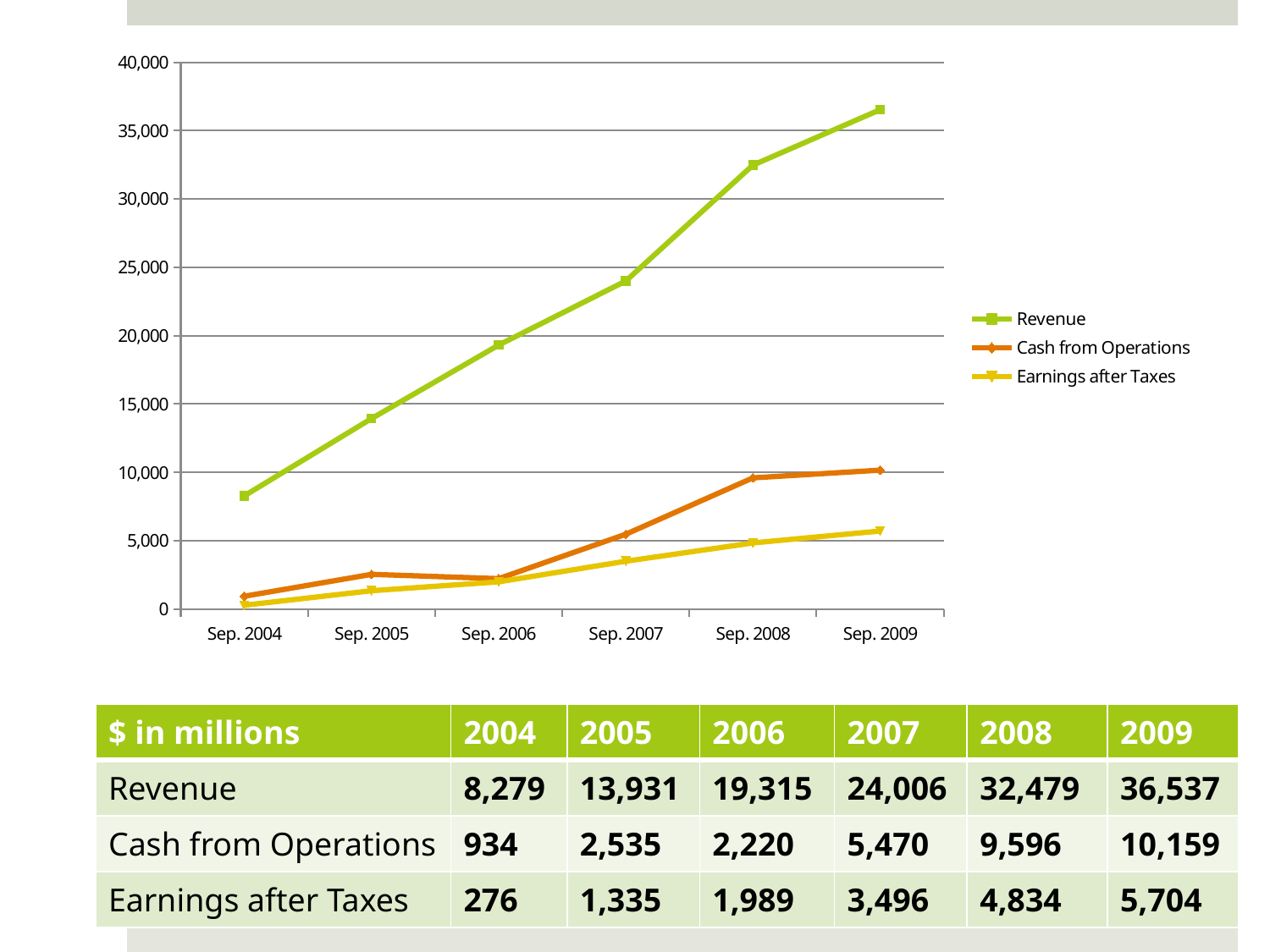
What is the difference between Revenue in 2009 and Revenue in 2008? 4,058 What kind of chart is shown on the slide? line chart Does Revenue rise or fall from Sep. 2004 to Sep. 2009? rise How many series does the chart legend list? 3 How many time points are plotted along the x axis of the chart? 6 What is the Revenue value for 2009? 36,537 Is the Revenue value for Sep. 2007 greater or less than 25,000? less What is the Cash from Operations value for 2007? 5,470 Which is larger in 2006: Cash from Operations or Earnings after Taxes? Cash from Operations In which year is Revenue highest? 2009 In which year is Cash from Operations lowest? 2004 What is the Earnings after Taxes value for 2004? 276